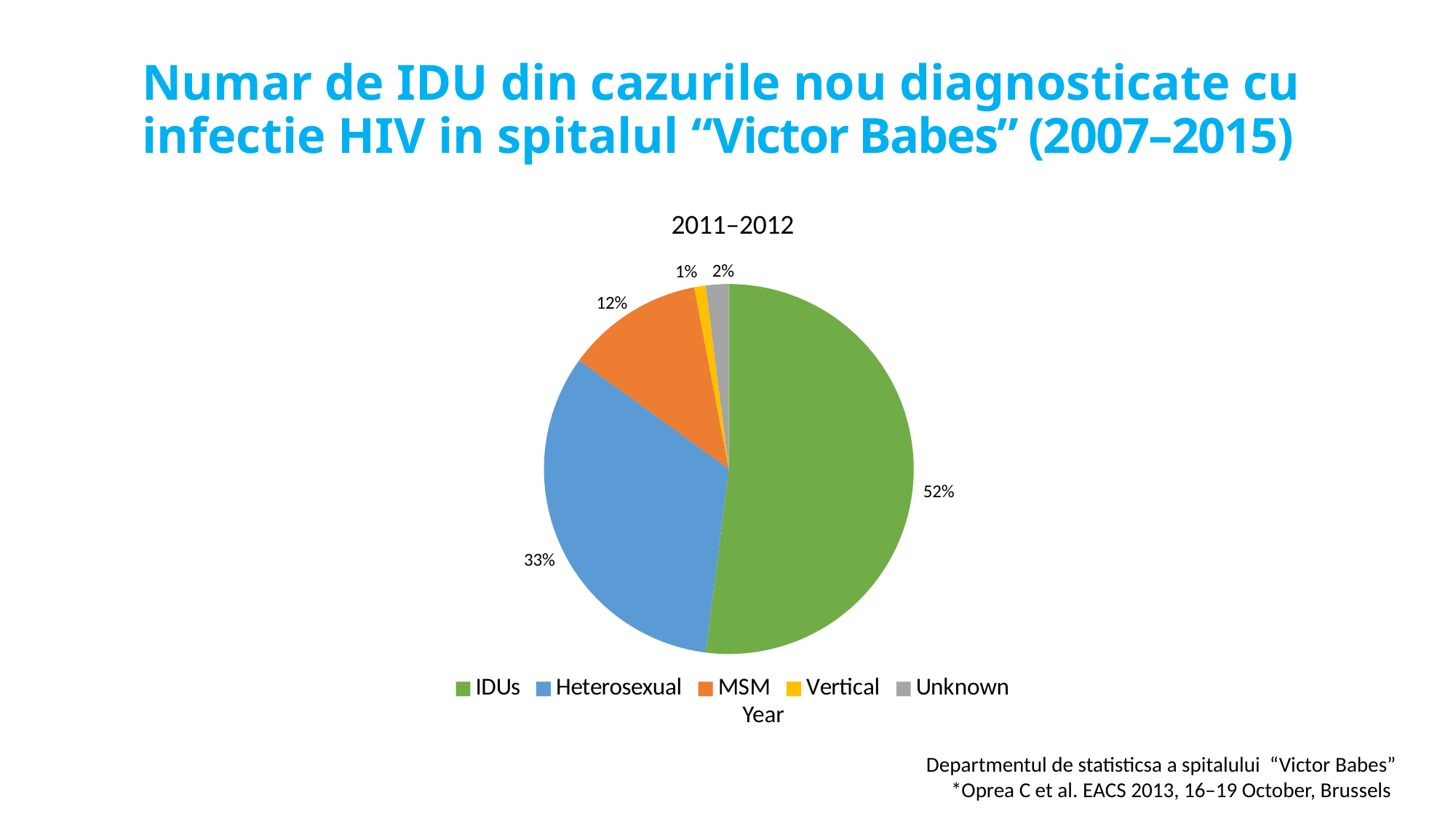
What share of the pie is Unknown? 2% What share of the pie is Heterosexual? 33% What is the chart's title? 2011–2012 What type of chart is shown on the slide? pie chart Which category has the largest slice? IDUs What share of the pie is Vertical? 1% How many categories does the legend list? 5 What is the difference in percentage points between IDUs and Heterosexual? 19 Which category has the smallest slice? Vertical Which is larger, MSM or Unknown? MSM